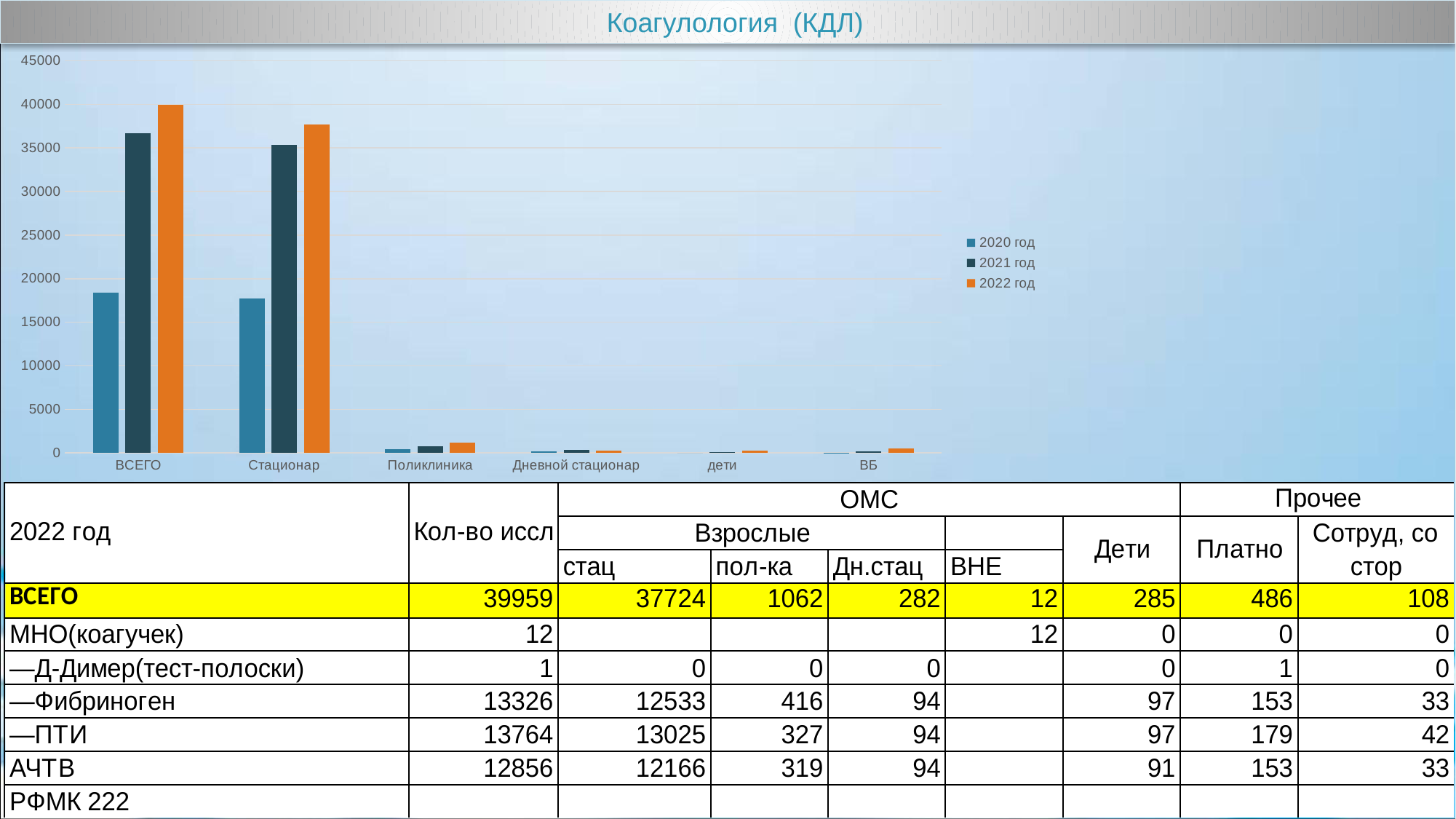
Which category has the tallest bar for the 2022 год series? ВСЕГО Is the value for ВСЕГО in 2022 год greater or less than 35000? greater Is the value for ВСЕГО in 2020 год greater or less than 20000? less For the Стационар category, which is larger: the 2020 год bar or the 2022 год bar? 2022 год For the ВСЕГО category, which year has the lowest bar? 2020 год How many categories are shown on the x axis of the chart? 6 What colour are the bars for the 2022 год series? orange What kind of chart is shown on the slide? bar chart Is the value for Поликлиника in 2022 год greater or less than 5000? less For the ВСЕГО category, do the bars rise or fall from 2020 год to 2022 год? rise How many series does the chart legend list? 3